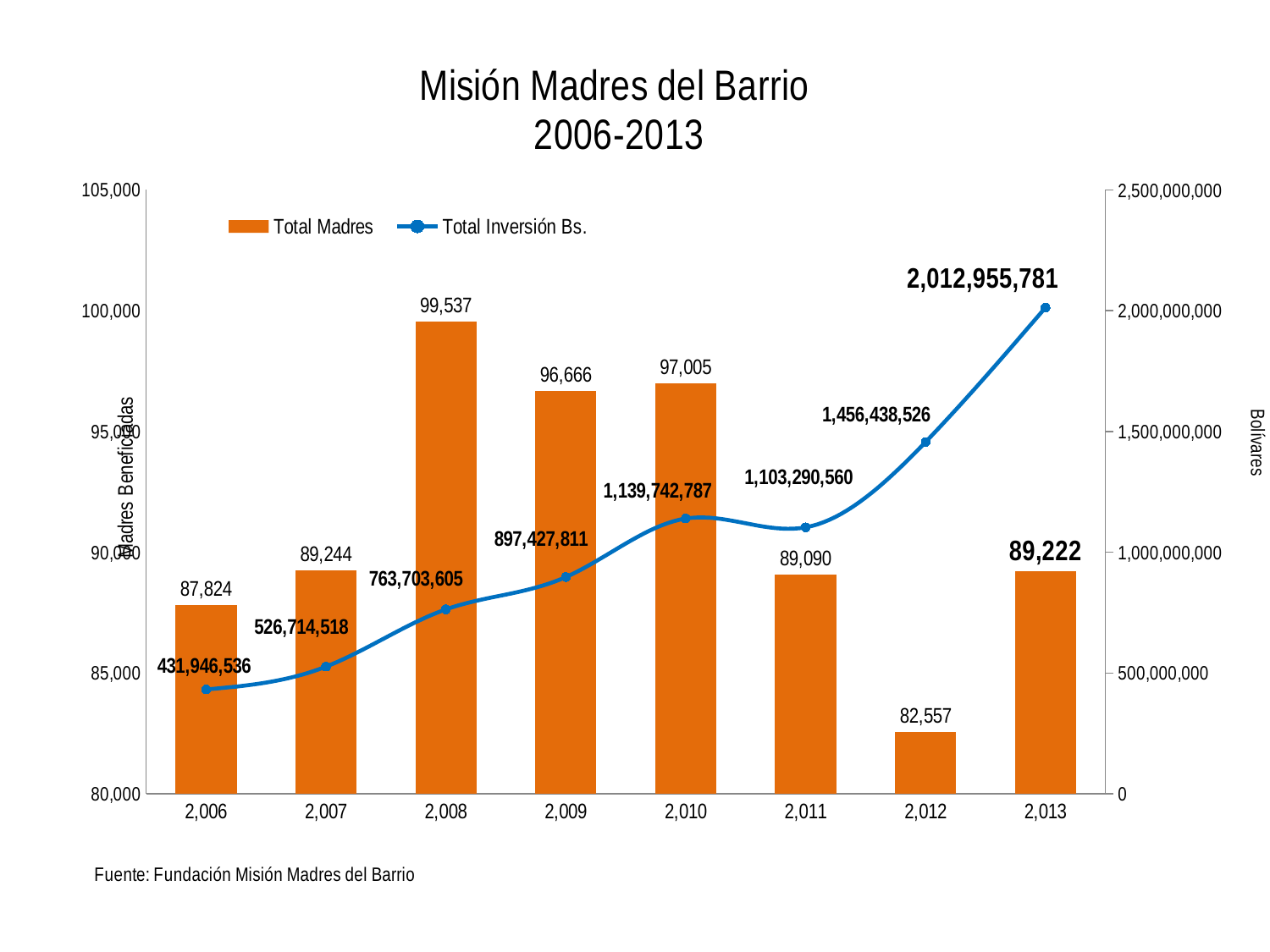
Which is larger, the Total Inversión Bs. value for 2010 or for 2011? 2010 What is the difference between the Total Madres values for 2008 and 2012? 16,980 What is the Total Inversión Bs. value for 2013? 2,012,955,781 Which year has the lowest Total Madres value? 2012 What is the Total Madres value for 2008? 99,537 How many series does the legend list? 2 What is the Total Madres value for 2012? 82,557 Which year has the lowest Total Inversión Bs. value? 2006 What is the Total Inversión Bs. value for 2006? 431,946,536 By how much did Total Inversión Bs. increase from 2012 to 2013? 556,517,255 How many years are shown on the x axis? 8 Which year has the highest Total Madres value? 2008